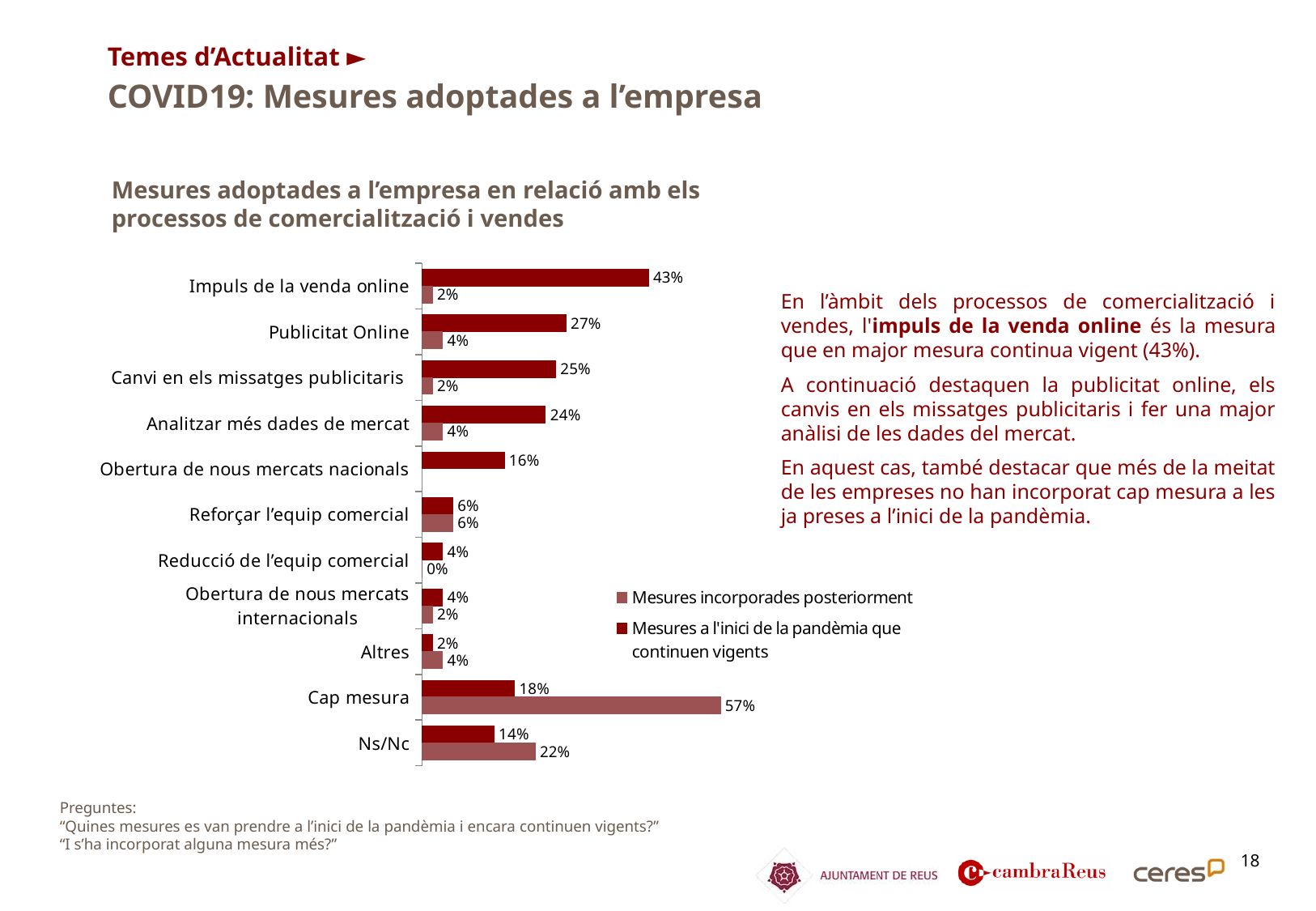
What is the value for 'Ns/Nc' in the series 'Mesures incorporades posteriorment'? 22% For 'Altres', which series has the larger value? Mesures incorporades posteriorment What is the difference between the two series values for 'Cap mesura'? 39% How many series does the legend list? 2 What kind of chart is shown on the slide? bar chart What is the value for 'Reducció de l'equip comercial' in the series 'Mesures incorporades posteriorment'? 0% Which category has the highest value in the series 'Mesures a l'inici de la pandèmia que continuen vigents'? Impuls de la venda online What is the difference between 'Impuls de la venda online' and 'Publicitat Online' in the series 'Mesures a l'inici de la pandèmia que continuen vigents'? 16% How many categories are shown on the chart? 11 What is the value for 'Cap mesura' in the series 'Mesures incorporades posteriorment'? 57% Which category has the highest value in the series 'Mesures incorporades posteriorment'? Cap mesura What is the value for 'Impuls de la venda online' in the series 'Mesures a l'inici de la pandèmia que continuen vigents'? 43%